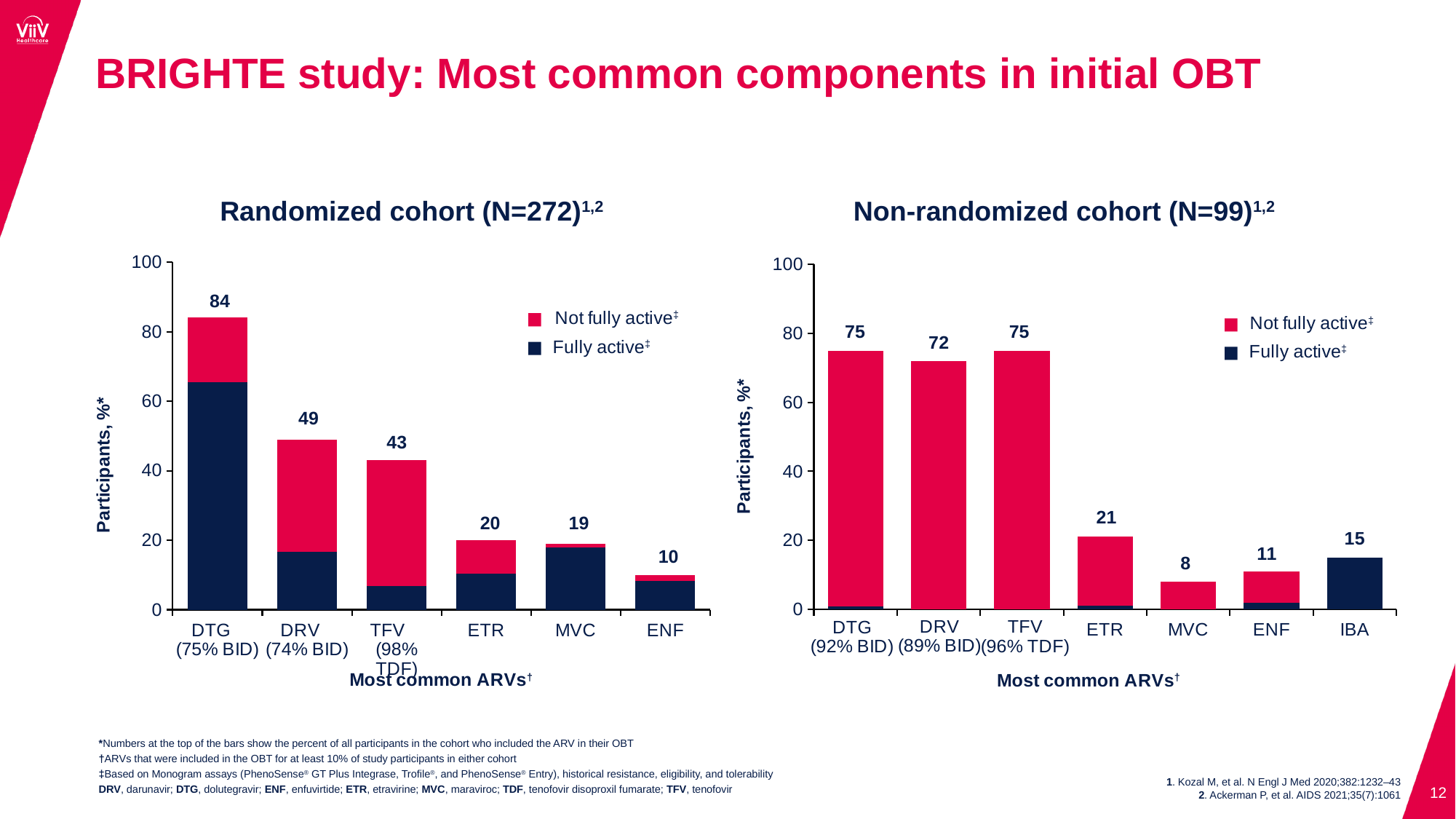
In the Randomized cohort chart, which ARV has the highest value? DTG In the Randomized cohort chart, what is the difference between the values for DTG and ENF? 74 In the Non-randomized cohort chart, which ARV has the lowest value? MVC How many ARV categories are shown in the Non-randomized cohort chart? 7 What type of chart is the Non-randomized cohort chart? Stacked bar chart In the Non-randomized cohort chart, which is larger, the value for ENF or the value for IBA? IBA In the Randomized cohort chart, what is the value shown for DTG? 84 In the Randomized cohort chart, what is the difference between the values for DRV and TFV? 6 What is the label on the y axis of the Randomized cohort chart? Participants, %* In the Randomized cohort chart, is the Fully active portion of the DTG bar greater or less than 60? greater How many series does the legend of the Randomized cohort chart list? 2 In the Non-randomized cohort chart, what is the value shown for ETR? 21